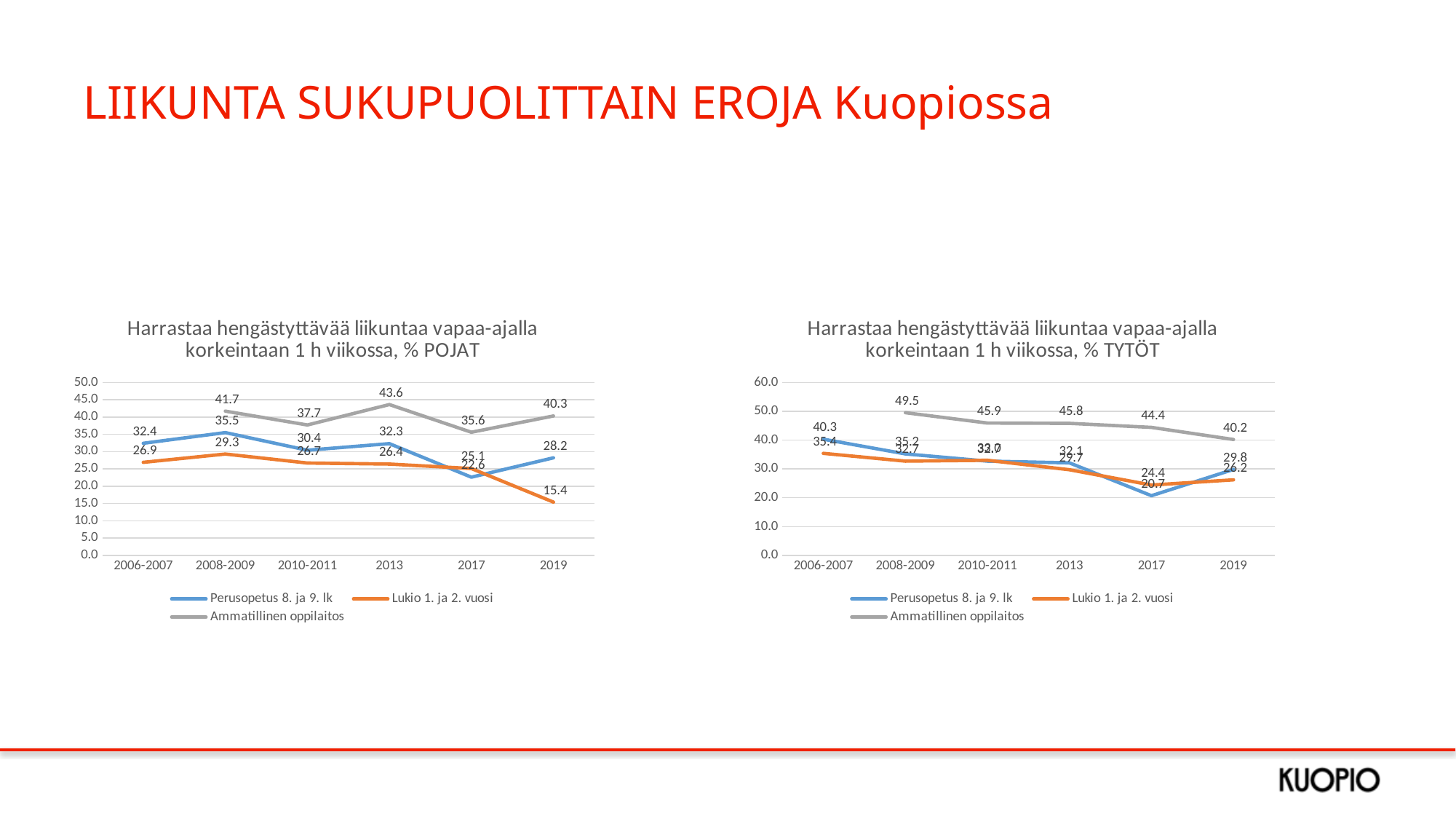
In the POJAT chart (left), what is the difference between Ammatillinen oppilaitos and Perusopetus 8. ja 9. lk in 2019? 12.1 In the TYTÖT chart (right), what is the value for Perusopetus 8. ja 9. lk in 2017? 20.7 In the POJAT chart (left), what is the value for Ammatillinen oppilaitos in 2013? 43.6 In the TYTÖT chart (right), does the Ammatillinen oppilaitos series rise or fall from 2008-2009 to 2019? fall In the TYTÖT chart (right), what is the value for Ammatillinen oppilaitos in 2008-2009? 49.5 In the POJAT chart (left), which series has the lowest value in 2019? Lukio 1. ja 2. vuosi In the TYTÖT chart (right), which is larger in 2017: Lukio 1. ja 2. vuosi or Perusopetus 8. ja 9. lk? Lukio 1. ja 2. vuosi How many series does the legend of the TYTÖT chart (right) list? 3 In the POJAT chart (left), in which year does Ammatillinen oppilaitos reach its highest value? 2013 In the POJAT chart (left), what is the value for Lukio 1. ja 2. vuosi in 2019? 15.4 In the POJAT chart (left), what is the value for Perusopetus 8. ja 9. lk in 2006-2007? 32.4 What type of chart is the POJAT chart (left)? line chart